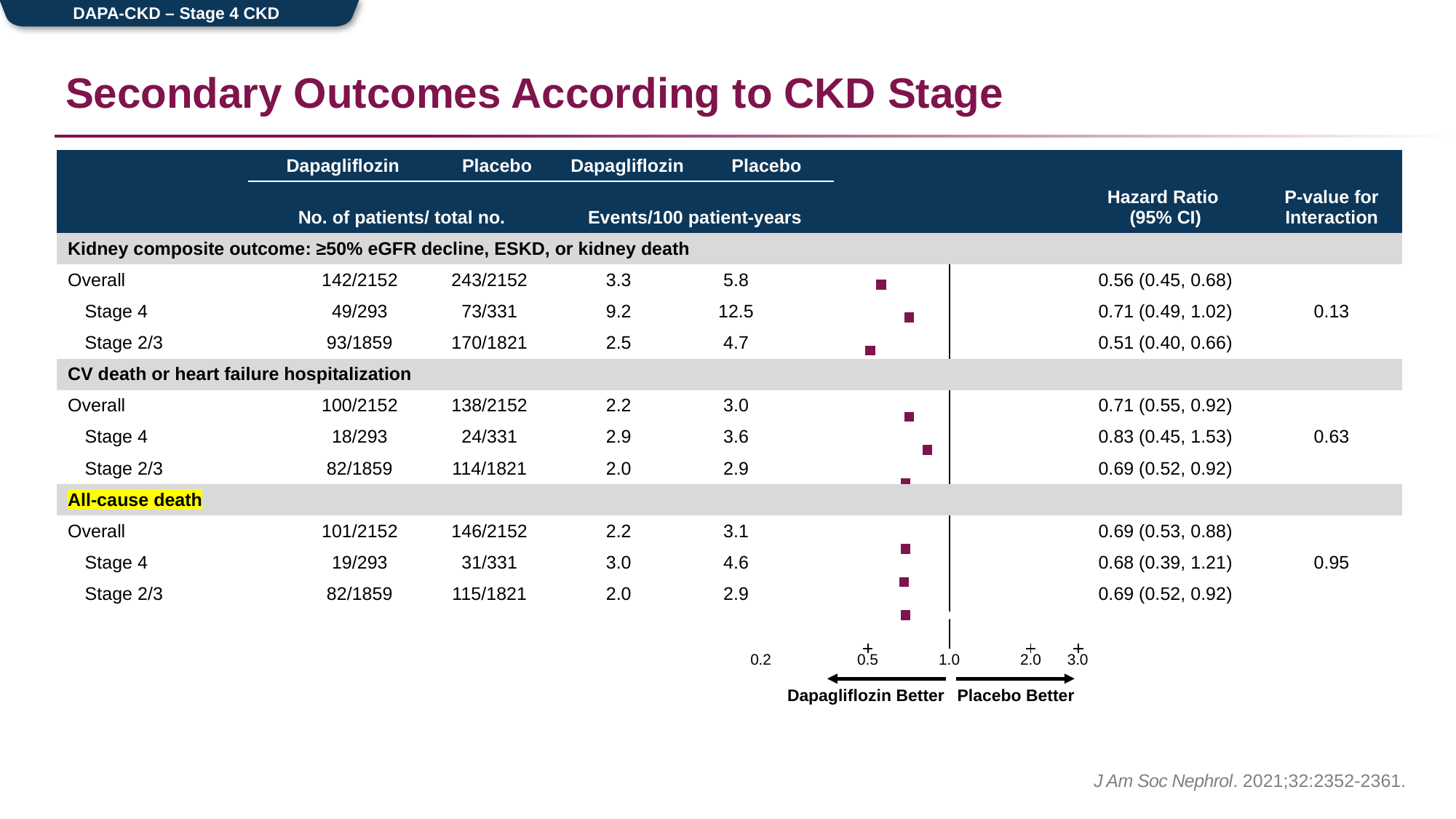
For the kidney composite outcome, which has the larger hazard ratio: Stage 4 or Stage 2/3? Stage 4 What does the left side of the forest plot's x axis indicate, according to the label below it? Dapagliflozin Better Which row in the forest plot has the lowest hazard ratio point estimate? Stage 2/3, kidney composite outcome (0.51) What is the hazard ratio (95% CI) for Stage 2/3 in the CV death or heart failure hospitalization outcome? 0.69 (0.52, 0.92) How many hazard ratio points are plotted in the forest plot? 9 Is the hazard ratio point estimate for Stage 4 in CV death or heart failure hospitalization greater or less than 1.0? less What kind of chart is shown on the slide? Forest plot What is the P-value for interaction for all-cause death? 0.95 What is the difference between the Stage 4 and Stage 2/3 hazard ratio point estimates for the kidney composite outcome? 0.20 What is the hazard ratio (95% CI) for the Overall row of all-cause death? 0.69 (0.53, 0.88) Which row in the forest plot has the highest hazard ratio point estimate? Stage 4, CV death or heart failure hospitalization (0.83) What is the hazard ratio (95% CI) plotted for Stage 4 in the kidney composite outcome? 0.71 (0.49, 1.02)